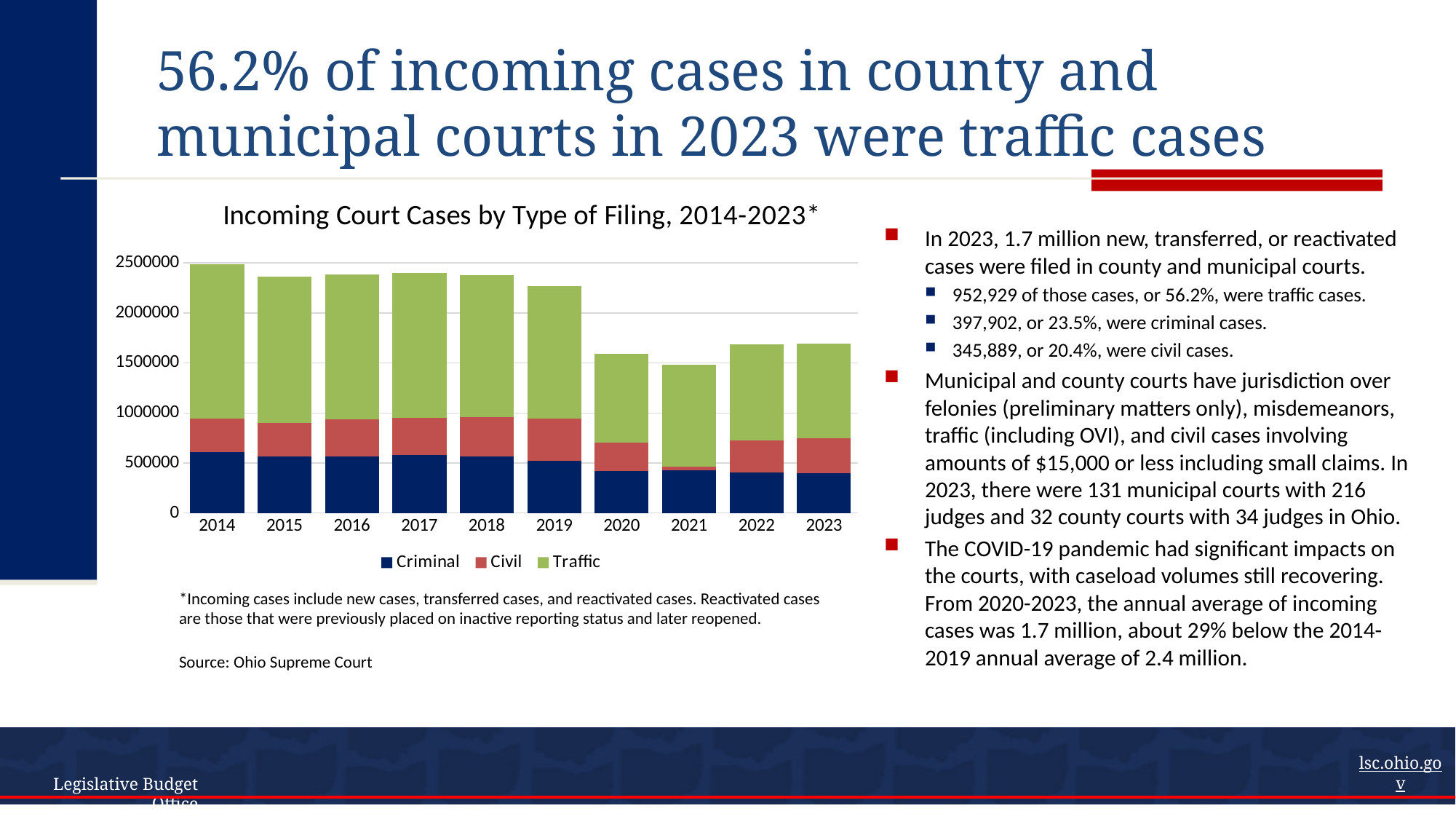
Overall, do the total incoming court cases rise or fall from 2014 to 2023? Fall Which year has the highest total of incoming court cases in the chart? 2014 What is the title of the chart? Incoming Court Cases by Type of Filing, 2014-2023* Which year has a larger total of incoming court cases, 2019 or 2020? 2019 Is the Criminal value for 2014 greater or less than 500000? greater Which year has the lowest total of incoming court cases in the chart? 2021 Is the total of incoming court cases for 2020 greater or less than 1500000? greater How many series does the chart's legend list? 3 Is the total of incoming court cases for 2019 greater or less than 2000000? greater How many years are shown on the x axis of the chart? 10 What kind of chart is shown on the slide? Stacked bar chart